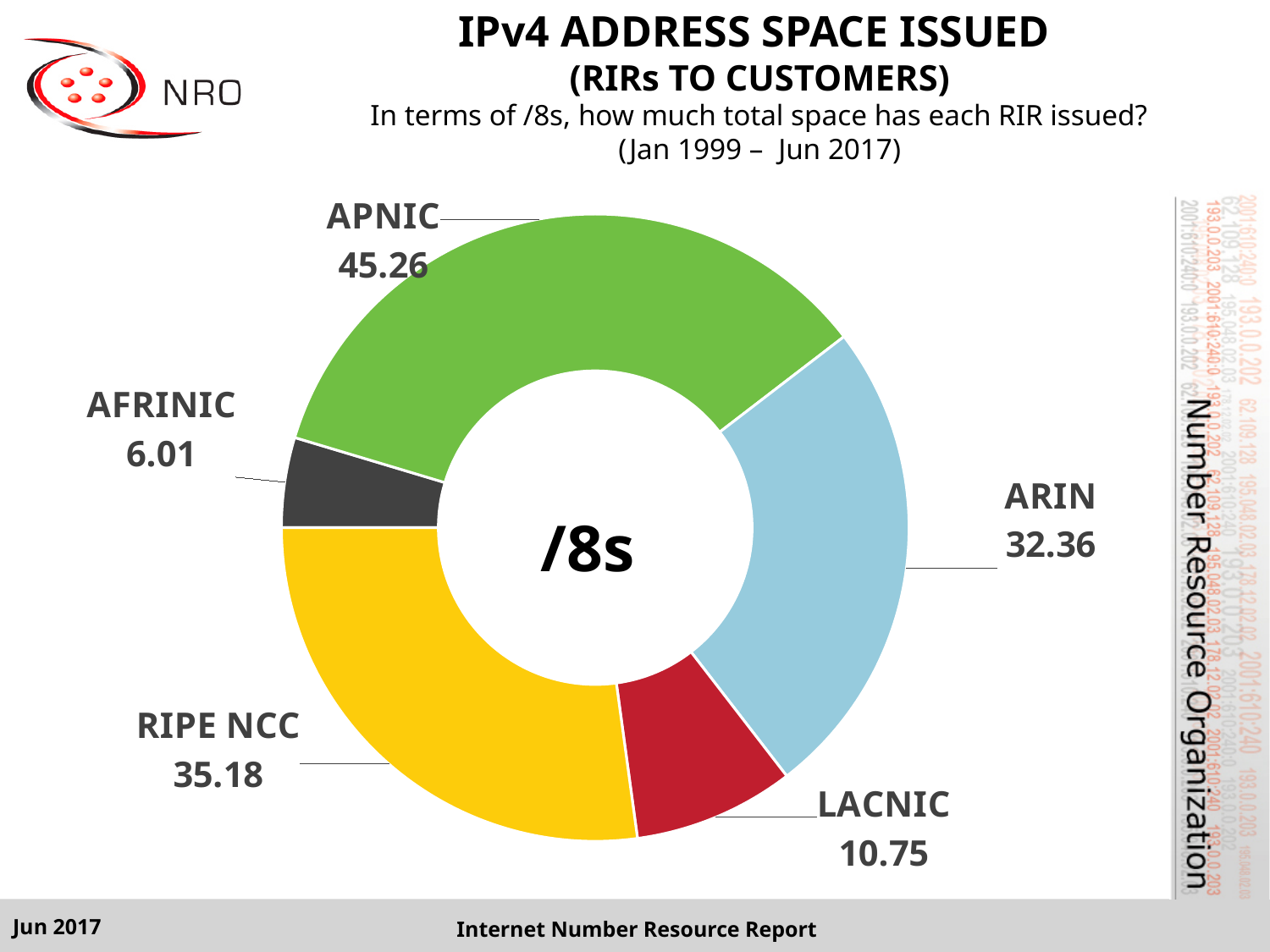
Which RIR has issued the most IPv4 address space in /8s? APNIC Which has issued more IPv4 space, RIPE NCC or ARIN? RIPE NCC What value is shown for AFRINIC? 6.01 What value is shown for ARIN? 32.36 What value is shown for RIPE NCC? 35.18 What is the difference between the RIPE NCC and ARIN values? 2.82 What value is shown for LACNIC? 10.75 Which RIR has issued the least IPv4 address space in /8s? AFRINIC How much more space has APNIC issued than ARIN, in /8s? 12.90 How many RIRs are shown in the chart? 5 What kind of chart is used on this slide? Pie (donut) chart What value is shown for APNIC in the IPv4 address space issued chart? 45.26